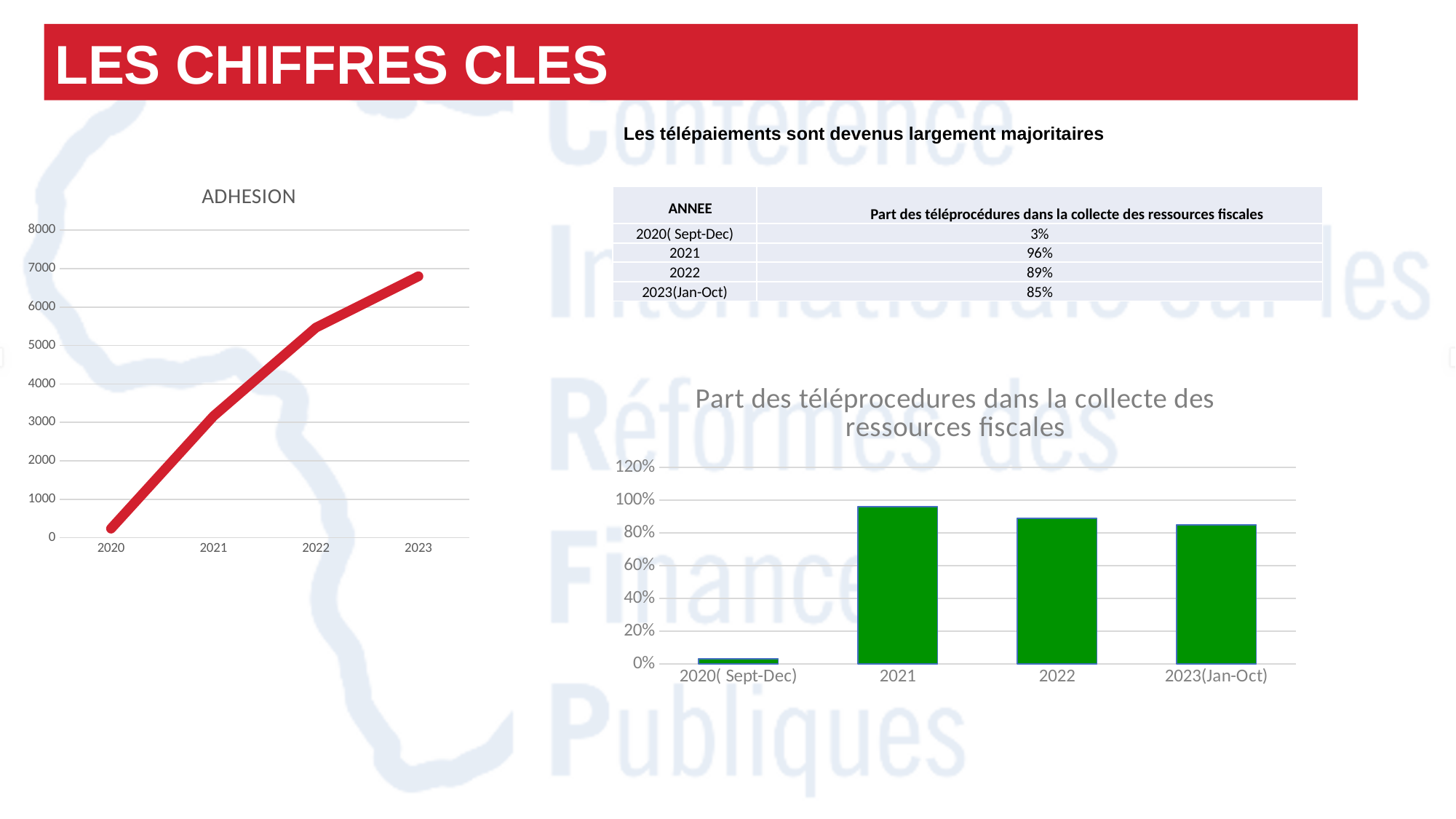
On the 'Part des téléprocedures dans la collecte des ressources fiscales' chart, what is the value for 2021? 96% What type of chart is 'Part des téléprocedures dans la collecte des ressources fiscales'? bar chart On the ADHESION chart, which year has the highest value? 2023 On the 'Part des téléprocedures dans la collecte des ressources fiscales' chart, which category has the lowest value? 2020( Sept-Dec) On the ADHESION chart, is the value for 2022 greater or less than 5000? greater What type of chart is the ADHESION chart? line chart On the 'Part des téléprocedures dans la collecte des ressources fiscales' chart, which is larger, 2022 or 2023(Jan-Oct)? 2022 On the ADHESION chart, is the value for 2020 greater or less than 1000? less How many years are plotted on the ADHESION chart? 4 On the ADHESION chart, is the value for 2023 greater or less than 7000? less On the 'Part des téléprocedures dans la collecte des ressources fiscales' chart, what is the difference between 2021 and 2023(Jan-Oct)? 11% On the ADHESION chart, do the values rise or fall from 2020 to 2023? rise